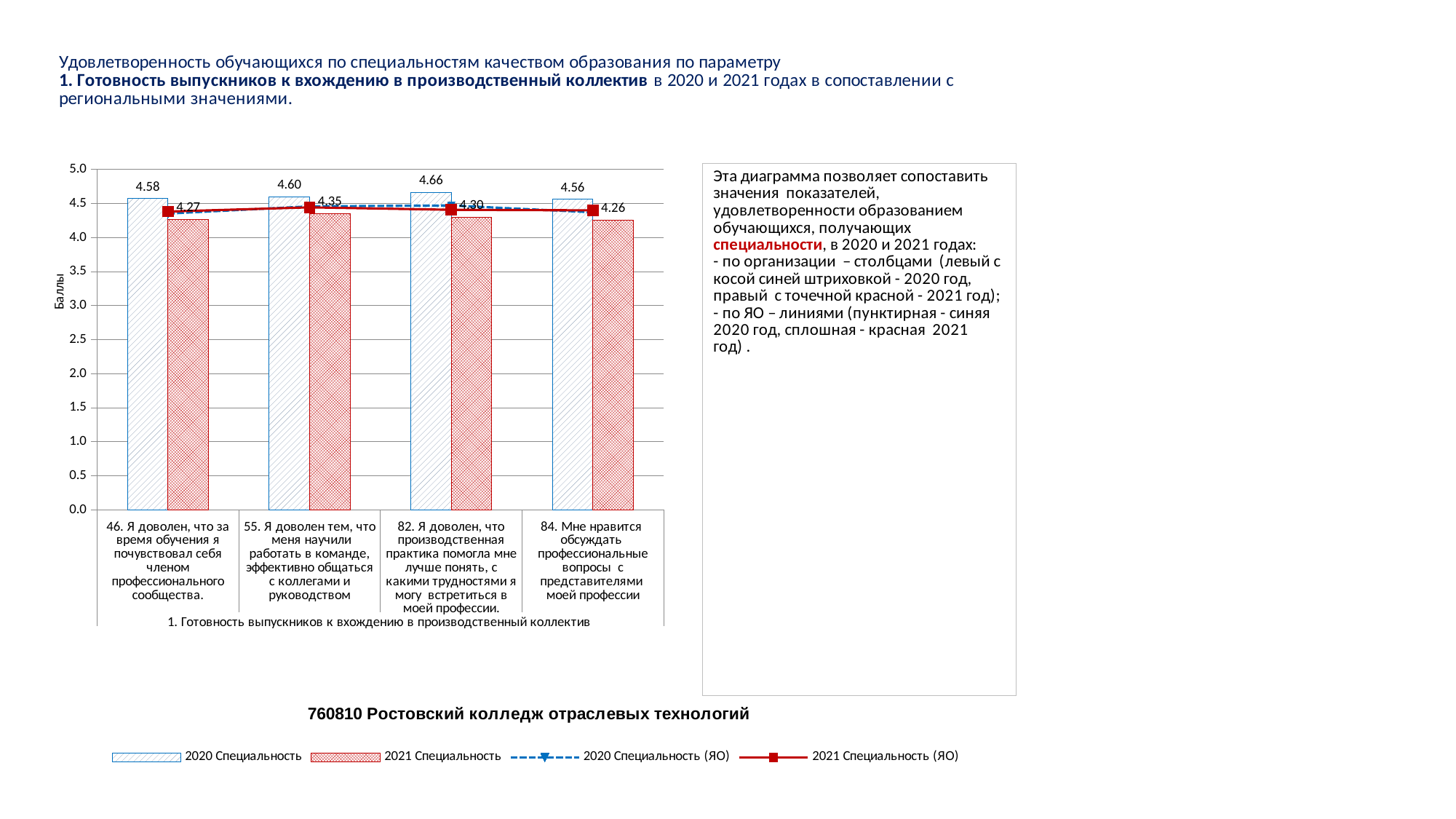
Which category has the highest 2020 Специальность value? 82. Я доволен, что производственная практика помогла мне лучше понять, с какими трудностями я могу встретиться в моей профессии. How many series does the chart legend list? 4 How many categories are shown on the x axis of the chart? 4 Is the 2021 Специальность value for category "55. Я доволен тем, что меня научили работать в команде, эффективно общаться с коллегами и руководством" greater or less than 4.0? greater What is the 2021 Специальность value for category "84. Мне нравится обсуждать профессиональные вопросы с представителями моей профессии"? 4.26 What is the 2020 Специальность value for category "46. Я доволен, что за время обучения я почувствовал себя членом профессионального сообщества."? 4.58 What is the 2020 Специальность value for category "82. Я доволен, что производственная практика помогла мне лучше понять, с какими трудностями я могу встретиться в моей профессии."? 4.66 What is the difference between the 2020 Специальность and 2021 Специальность values for category "82. Я доволен, что производственная практика помогла мне лучше понять, с какими трудностями я могу встретиться в моей профессии."? 0.36 Which is larger for category "46. Я доволен, что за время обучения я почувствовал себя членом профессионального сообщества.": the 2020 Специальность value or the 2021 Специальность value? 2020 Специальность What is the 2021 Специальность value for category "55. Я доволен тем, что меня научили работать в команде, эффективно общаться с коллегами и руководством"? 4.35 What is the label of the vertical axis of the chart? Баллы Which category has the lowest 2021 Специальность value? 84. Мне нравится обсуждать профессиональные вопросы с представителями моей профессии